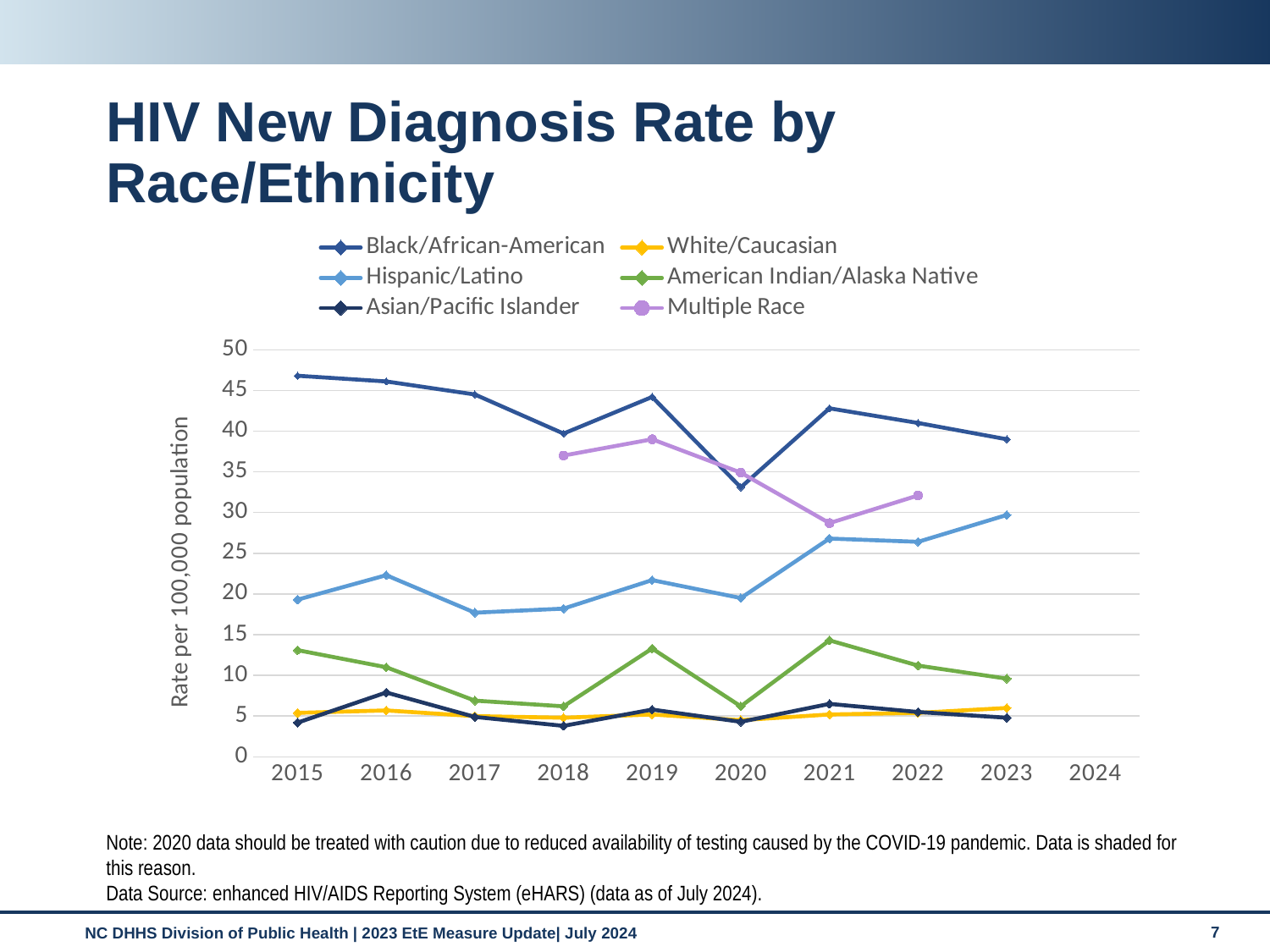
In 2019, which is larger: the rate for Black/African-American or for Multiple Race? Black/African-American Does the Hispanic/Latino rate rise or fall from 2020 to 2023? rise Is the value for American Indian/Alaska Native in 2021 greater or less than 10? greater What is the label on the y axis? Rate per 100,000 population How many series does the legend list? 6 Is the value for Black/African-American in 2020 greater or less than 35? less What kind of chart is shown on the slide? line chart In which year is the Black/African-American rate at its lowest? 2020 Which race/ethnicity group has the highest new diagnosis rate in 2015? Black/African-American Is the value for Black/African-American in 2015 greater or less than 45? greater How many years are labeled on the x axis? 10